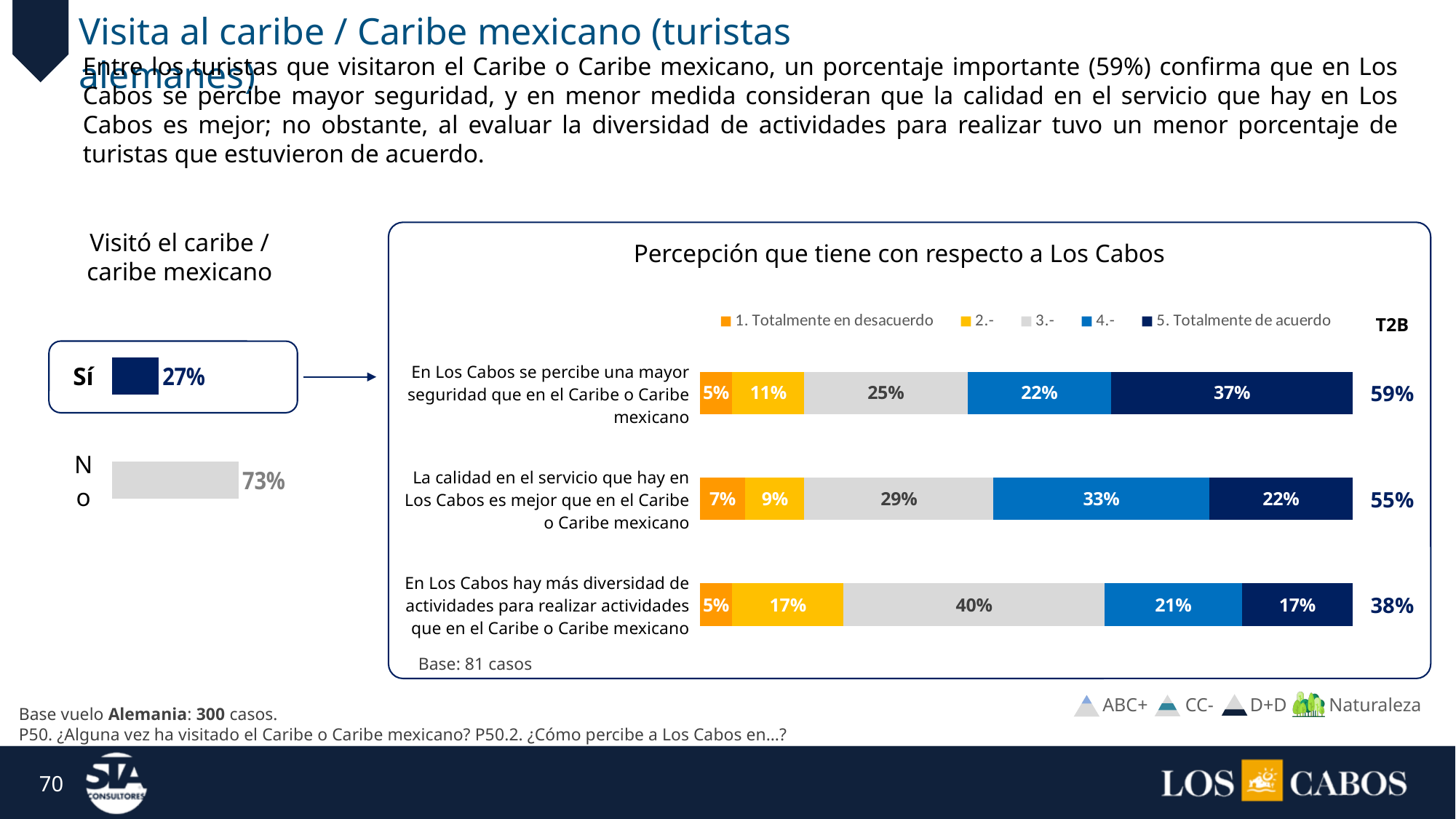
In the 'Visitó el caribe / caribe mexicano' chart, what percentage answered 'No'? 73% In the 'Percepción que tiene con respecto a Los Cabos' chart, what is the difference between the '5. Totalmente de acuerdo' values for the 'mayor seguridad' statement and the 'más diversidad de actividades' statement? 20% In the 'Percepción que tiene con respecto a Los Cabos' chart, how many statements are plotted? 3 What kind of chart is 'Percepción que tiene con respecto a Los Cabos'? Stacked bar chart In the 'Percepción que tiene con respecto a Los Cabos' chart, what is the '3.-' value for 'En Los Cabos hay más diversidad de actividades para realizar actividades que en el Caribe o Caribe mexicano'? 40% In the 'Percepción que tiene con respecto a Los Cabos' chart, what is the T2B value for 'La calidad en el servicio que hay en Los Cabos es mejor que en el Caribe o Caribe mexicano'? 55% In the 'Percepción que tiene con respecto a Los Cabos' chart, what is the '5. Totalmente de acuerdo' value for 'En Los Cabos se percibe una mayor seguridad que en el Caribe o Caribe mexicano'? 37% In the 'Percepción que tiene con respecto a Los Cabos' chart, which statement has the highest '4.-' value? La calidad en el servicio que hay en Los Cabos es mejor que en el Caribe o Caribe mexicano In the 'Visitó el caribe / caribe mexicano' chart, which answer has the higher value, 'Sí' or 'No'? No In the 'Percepción que tiene con respecto a Los Cabos' chart, which statement has the lowest T2B value? En Los Cabos hay más diversidad de actividades para realizar actividades que en el Caribe o Caribe mexicano In the 'Percepción que tiene con respecto a Los Cabos' chart, how many series does the legend list? 5 In the 'Visitó el caribe / caribe mexicano' chart, what percentage answered 'Sí'? 27%